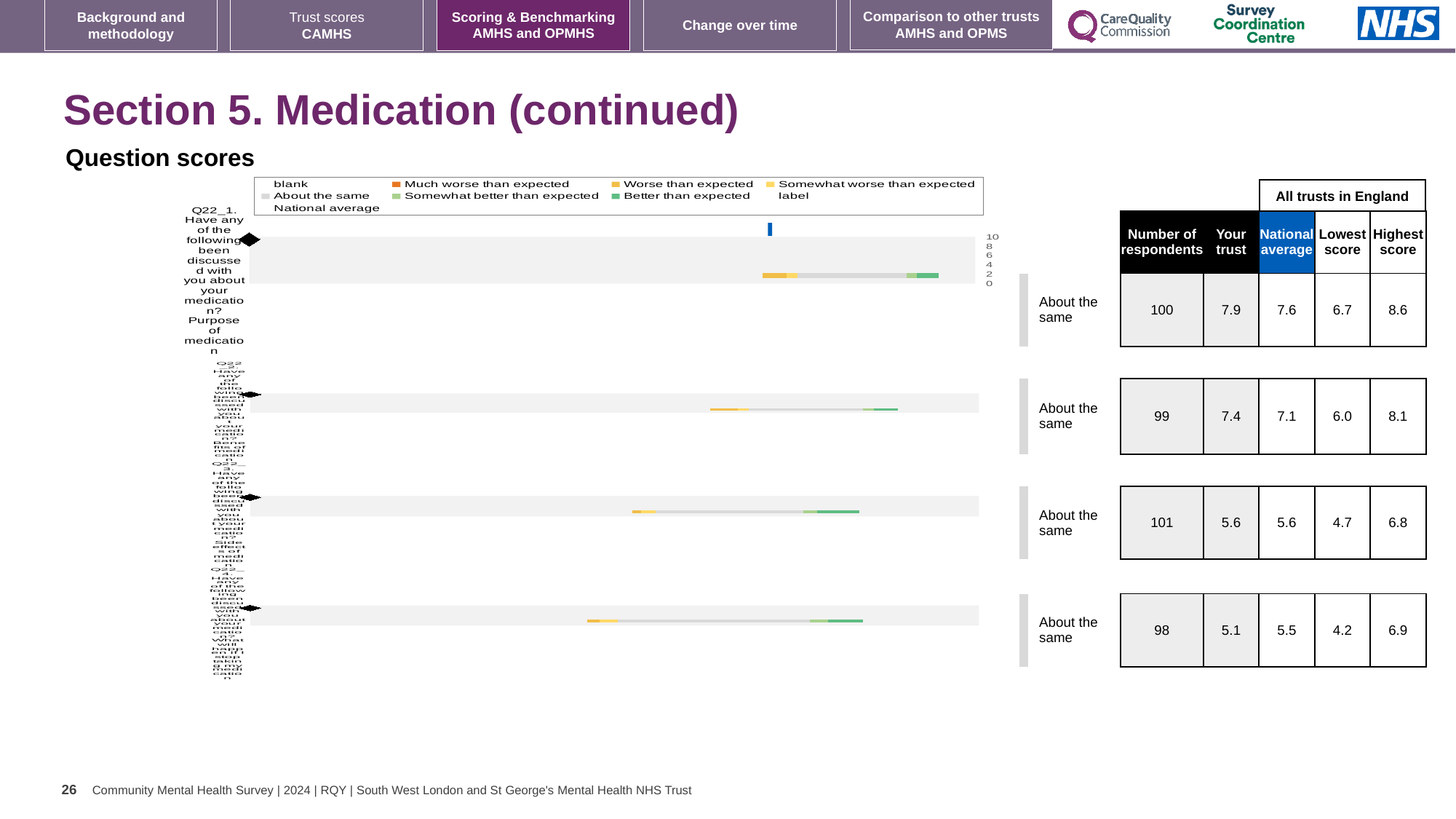
How many question rows (charts) are shown on the slide? 4 What is the lowest score across all trusts in England for the fourth row (Q22_4)? 4.2 Which question row has the lowest 'Your trust' score? Q22_4 (the fourth row) For the fourth row (Q22_4), what is the difference between the national average (5.5) and the 'Your trust' score (5.1)? 0.4 What is the 'Your trust' score for Q22_1 (Purpose of medication), the first row of the chart? 7.9 What kind of chart is used for the question scores? Bar chart For the first row (Q22_1), what is the difference between the highest score (8.6) and the lowest score (6.7)? 1.9 For the first row (Q22_1), which is larger: the 'Your trust' score or the national average? Your trust What benchmark category is shown next to each of the four question rows? About the same How many respondents are shown for the third row (Q22_3, Side effects of medication)? 101 Which question row has the highest 'Your trust' score? Q22_1 (Purpose of medication) What is the national average score for Q22_1 (Purpose of medication), the first row? 7.6